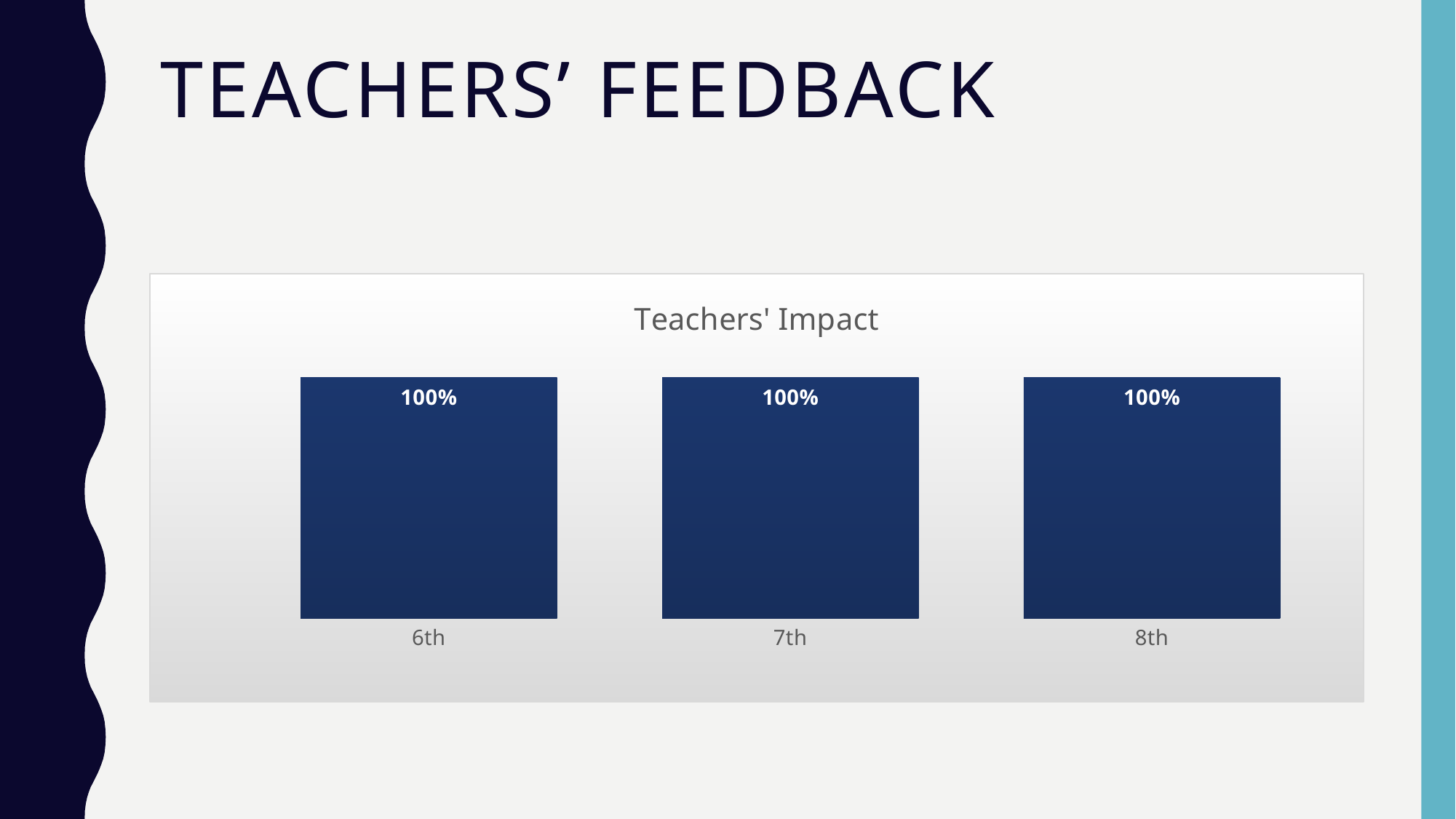
What is the value for 8th in the Teachers' Impact chart? 100% What is the value for 7th in the Teachers' Impact chart? 100% What is the value for 6th in the Teachers' Impact chart? 100% What is the title of the chart? Teachers' Impact What is the difference between the values for 6th and 8th? 0% How many categories are shown in the Teachers' Impact chart? 3 Do the values rise, fall, or stay the same from 6th to 8th? Stay the same What colour are the bars in the chart? Dark blue Is the value for 7th greater or less than 50%? greater What kind of chart is shown on the slide? Bar chart